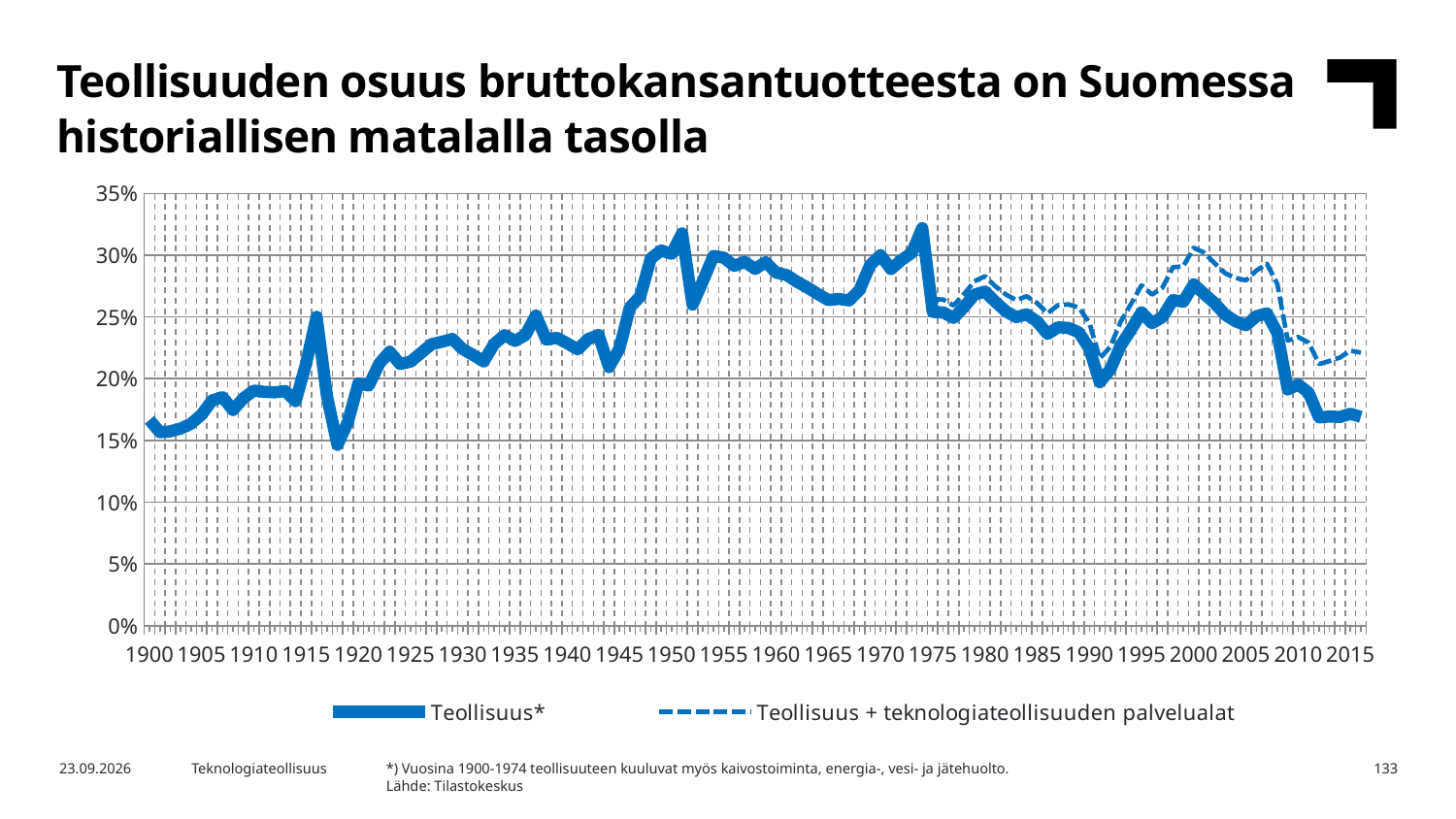
What is the highest value shown on the vertical axis? 35% Which year has the higher value for the Teollisuus* series: 1950 or 2015? 1950 Is the value of the Teollisuus + teknologiateollisuuden palvelualat series in 1980 greater or less than 25%? greater In 2015, which series has the higher value: Teollisuus* or Teollisuus + teknologiateollisuuden palvelualat? Teollisuus + teknologiateollisuuden palvelualat How many series does the legend list? 2 Is the value of the Teollisuus* series in 1925 greater or less than 20%? greater Is the value of the Teollisuus* series in 2015 greater or less than 20%? less What kind of chart is shown on the slide? line chart Does the Teollisuus* series rise or fall between 2005 and 2015? fall What is the label of the series drawn with a dashed line? Teollisuus + teknologiateollisuuden palvelualat